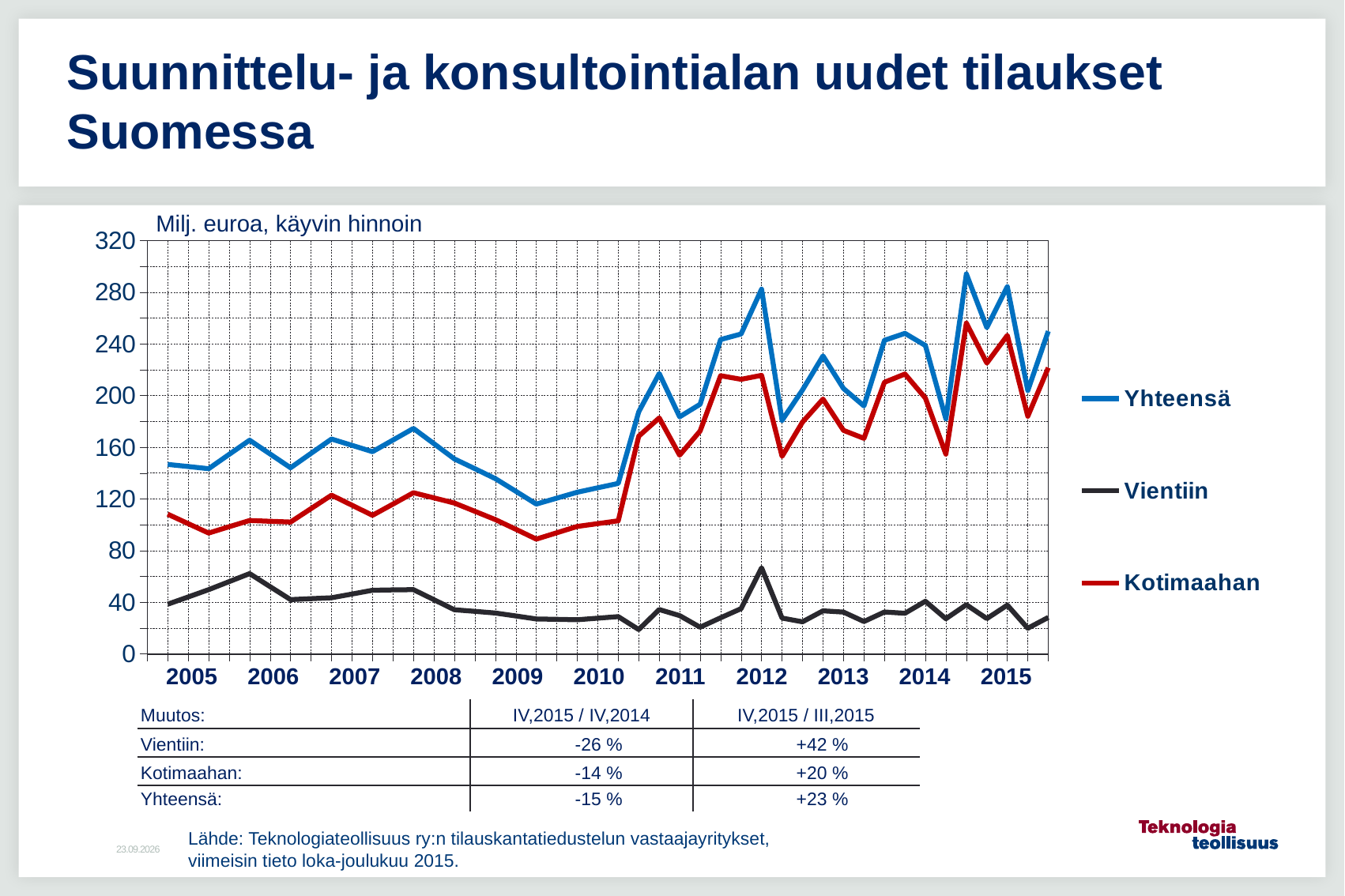
Is the peak value of Yhteensä in 2014 greater or less than 280? greater How many series does the legend list? 3 Which series is shown in red in the legend? Kotimaahan Is the value of Kotimaahan at its low point in 2009 greater or less than 120? less Which is larger in 2012, Kotimaahan or Vientiin? Kotimaahan What unit label is shown above the chart's y axis? Milj. euroa, käyvin hinnoin Does the Yhteensä series rise or fall from 2009 to 2012? rise Is the peak value of Vientiin in 2012 greater or less than 40? greater Which series has the highest values throughout the chart? Yhteensä Which series has the lowest values throughout the chart? Vientiin What kind of chart is shown on the slide? line chart How many years are labelled on the x axis? 11